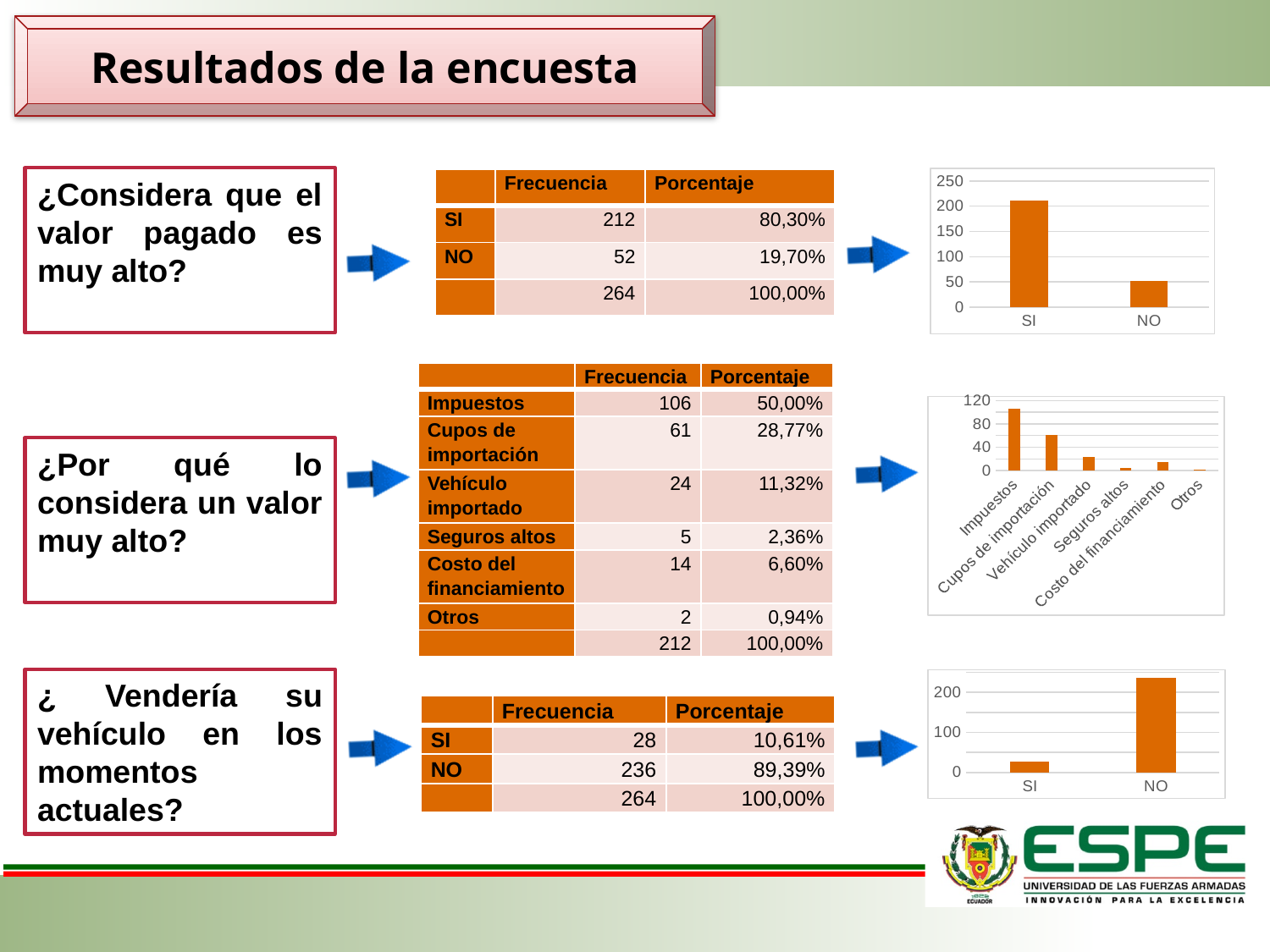
In the bottom chart, which category has the highest bar? NO How many categories are shown in the middle chart? 6 In the bottom chart, is the value for NO greater or less than 200? greater In the middle chart, which category has the highest bar? Impuestos In the middle chart, which is larger, Vehículo importado or Costo del financiamiento? Vehículo importado In the middle chart, is the value for Impuestos greater or less than 80? greater In the top chart, is the value for SI greater or less than 200? greater In the middle chart, which category has the lowest bar? Otros How many categories are shown in the bottom chart? 2 What type of chart is the top chart on the slide? bar chart In the top chart, which category has the highest bar? SI